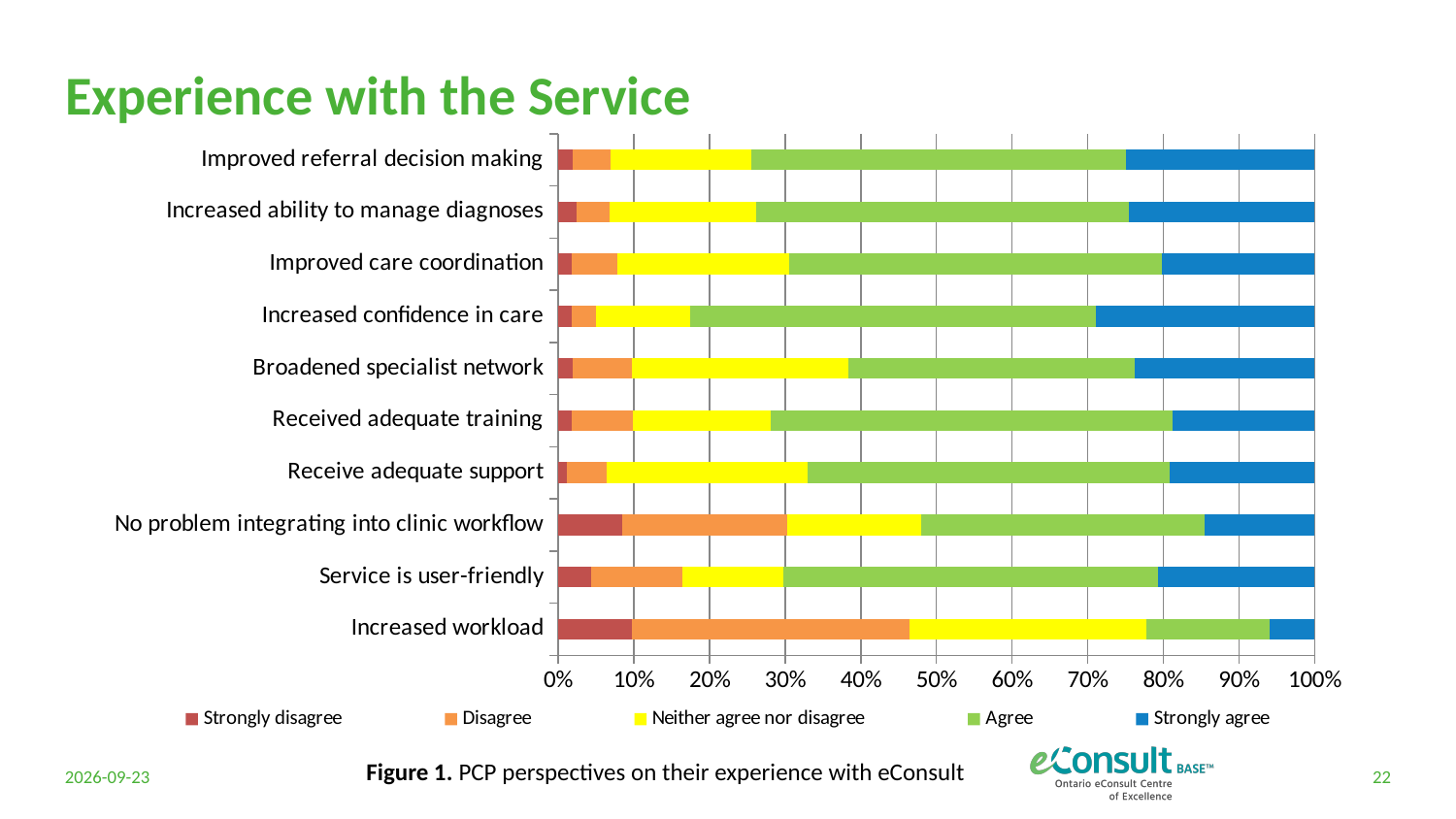
Is the Strongly agree segment for 'Increased workload' greater or less than 10%? less Which legend entry is shown in yellow? Neither agree nor disagree Which category has the largest Disagree segment? Increased workload How many categories (statements) are plotted on the chart? 10 What is the title of the slide containing the chart? Experience with the Service Which category has the smallest Strongly agree segment? Increased workload How many series does the legend list? 5 Is the Disagree segment for 'Increased workload' greater or less than 30%? greater What kind of chart is shown on the slide? Stacked bar chart Is the Strongly disagree segment for 'Increased workload' greater or less than 20%? less Which is larger: the Strongly agree segment for 'Increased confidence in care' or for 'Increased workload'? Increased confidence in care